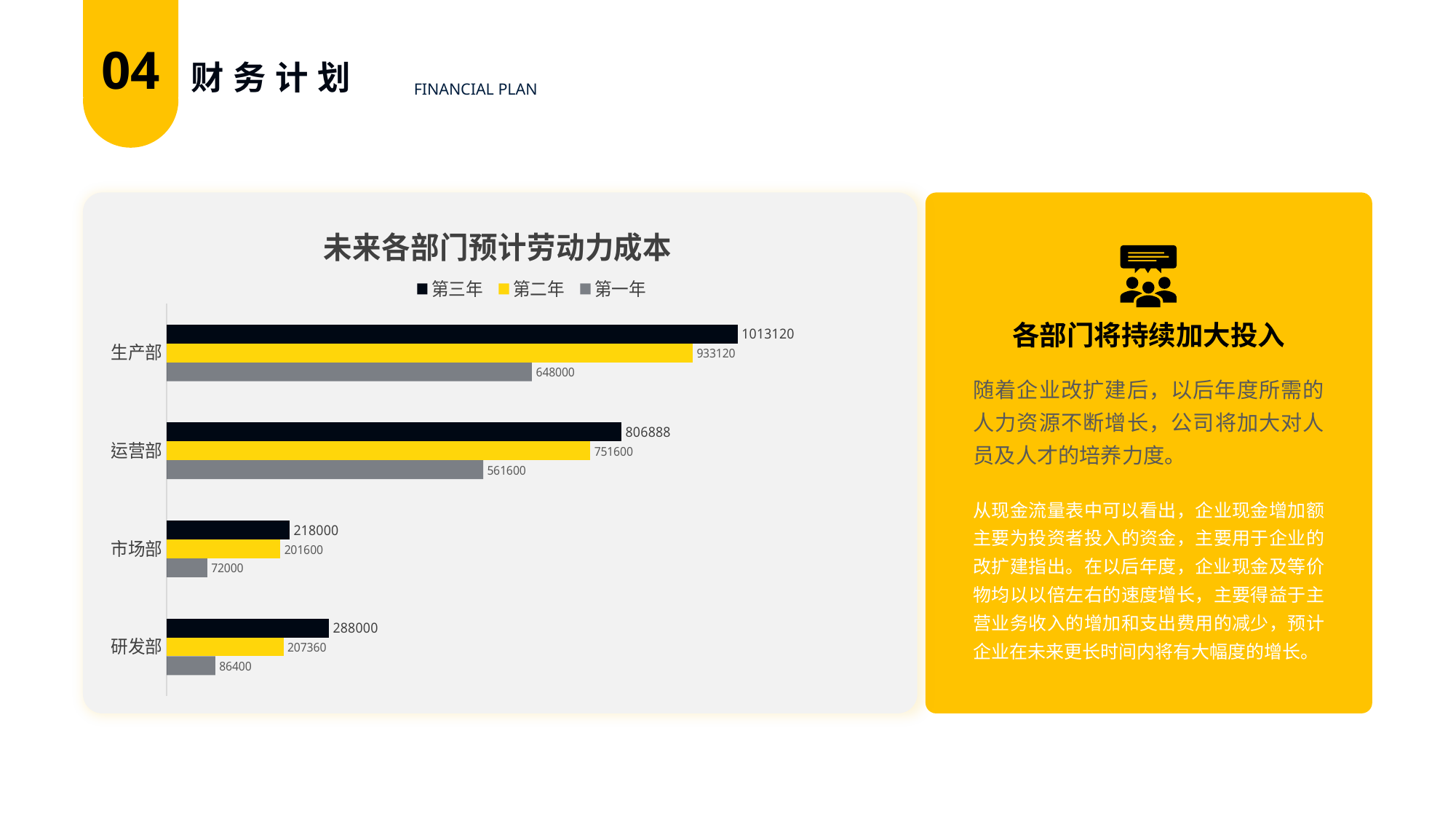
What is the title of the chart? 未来各部门预计劳动力成本 What is the difference between the 第三年 and 第二年 values for 生产部? 80000 What is the 第二年 value for 研发部? 207360 Which department has the highest 第三年 value? 生产部 What is the 第三年 value for 生产部? 1013120 How many departments (categories) are shown on the chart? 4 Which is larger: the 第三年 value for 研发部 or the 第三年 value for 市场部? 研发部 What is the 第一年 value for 运营部? 561600 Which colour represents 第二年 in the chart? Yellow What type of chart is shown on the slide? Bar chart Which department has the lowest 第一年 value? 市场部 How many series does the chart legend list? 3